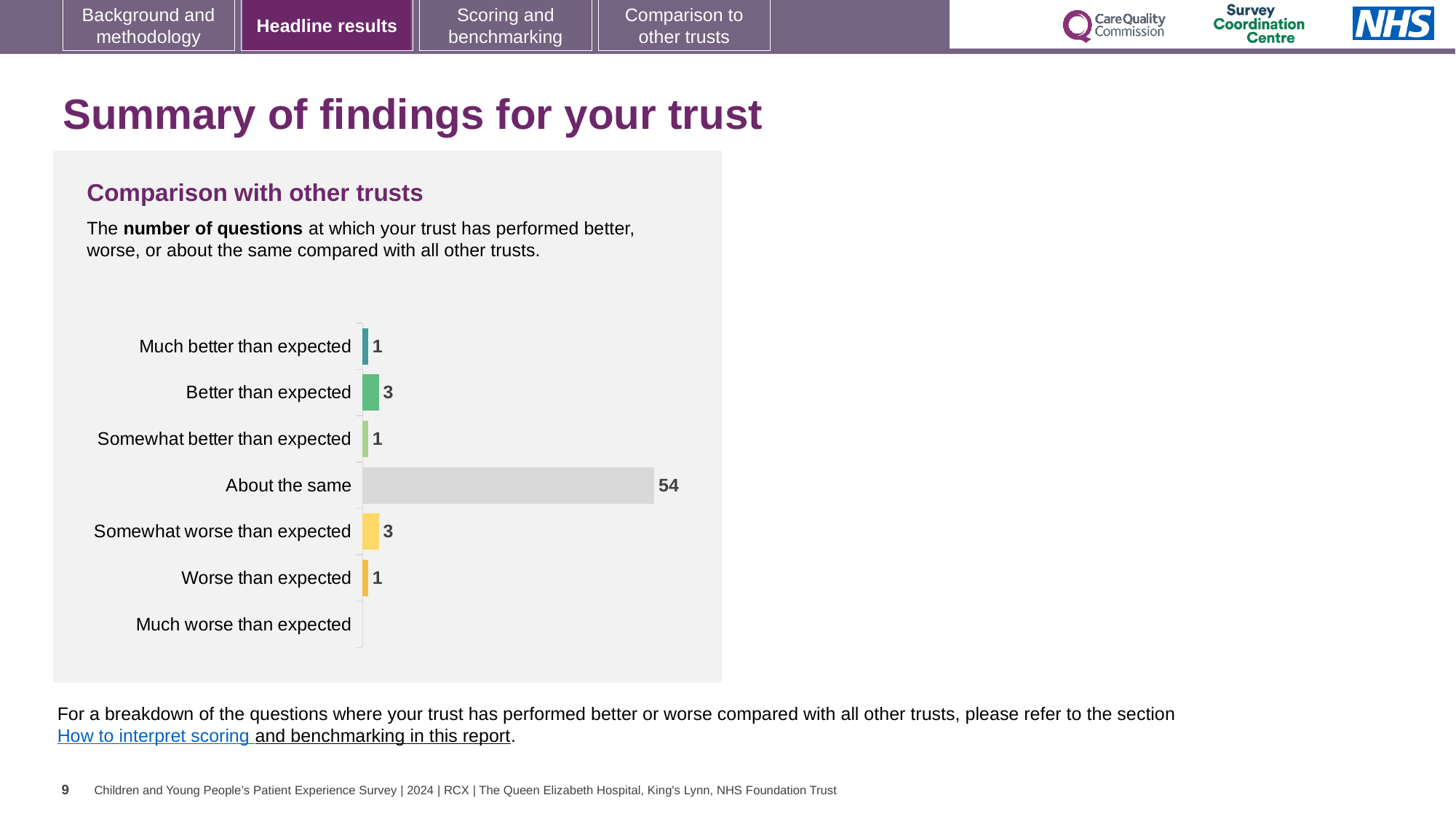
What kind of chart is shown on the slide? Bar chart What colour is the bar for 'About the same'? Grey How many questions were rated 'About the same'? 54 What is the value for 'Better than expected'? 3 What is the difference between 'About the same' and 'Better than expected'? 51 What is the value for 'Somewhat worse than expected'? 3 How many categories are shown on the chart? 7 What is the value for 'Much better than expected'? 1 What is the total number of questions across 'Much better than expected', 'Better than expected' and 'Somewhat better than expected'? 5 Which category has the highest number of questions? About the same Which is larger, 'Better than expected' or 'Somewhat better than expected'? Better than expected What is the title of the chart? Comparison with other trusts